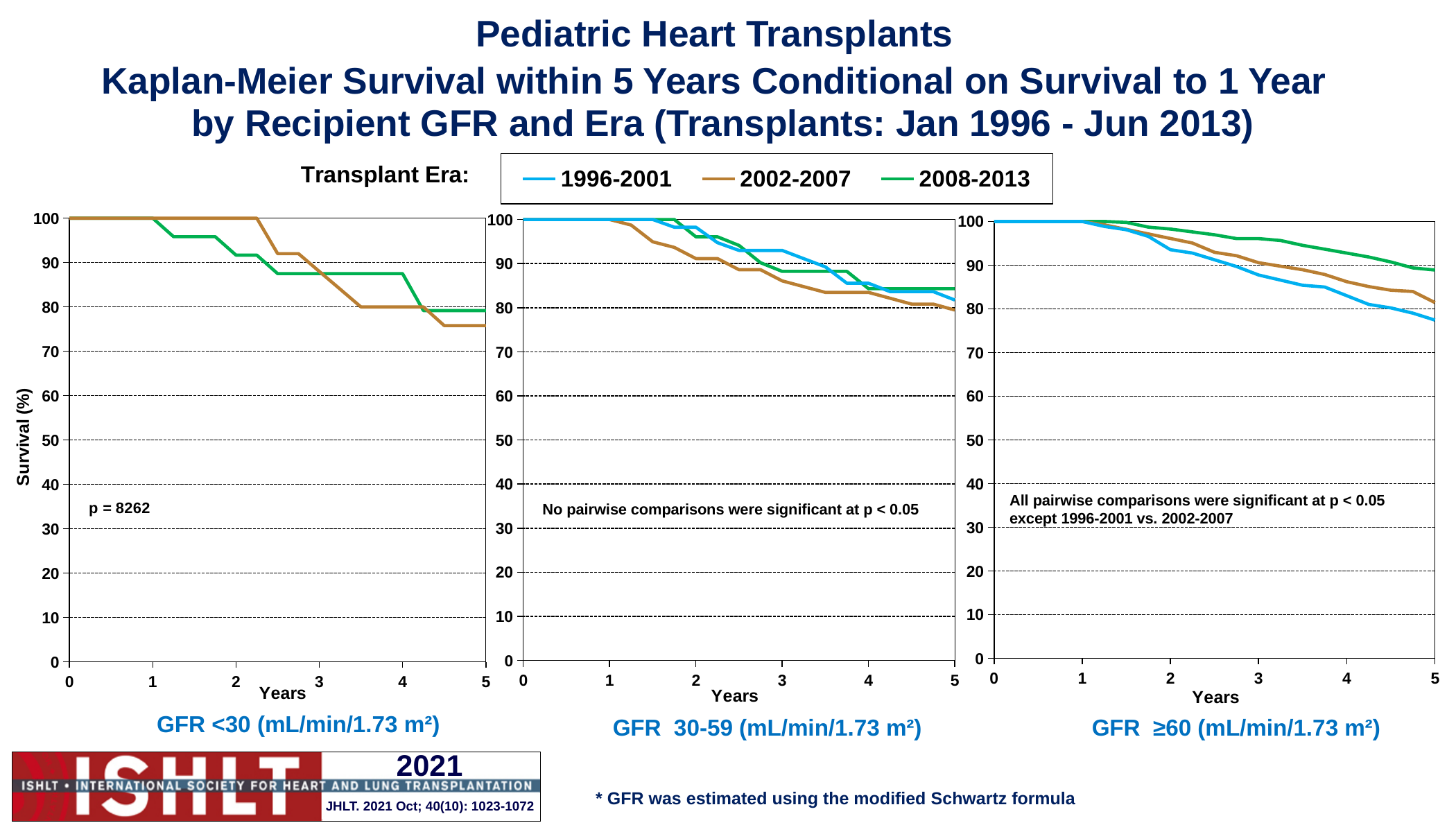
In the GFR ≥60 (mL/min/1.73 m²) chart, is the survival for 2008-2013 at 5 years greater or less than 80? greater In the GFR 30-59 (mL/min/1.73 m²) chart, is the survival for 2002-2007 at 5 years greater or less than 70? greater In the GFR ≥60 (mL/min/1.73 m²) chart, is the survival for 1996-2001 at 5 years greater or less than 80? less How many transplant eras does the legend list? 3 Which transplant eras are listed in the legend? 1996-2001, 2002-2007, 2008-2013 What kind of chart is used in the GFR ≥60 (mL/min/1.73 m²) panel? line chart In the GFR <30 (mL/min/1.73 m²) chart, how many era curves are plotted? 2 In the GFR ≥60 (mL/min/1.73 m²) chart, does the 1996-2001 survival curve rise or fall as years increase? fall In the GFR ≥60 (mL/min/1.73 m²) chart, which era has higher survival at 5 years, 2008-2013 or 1996-2001? 2008-2013 How many survival chart panels are shown on the slide? 3